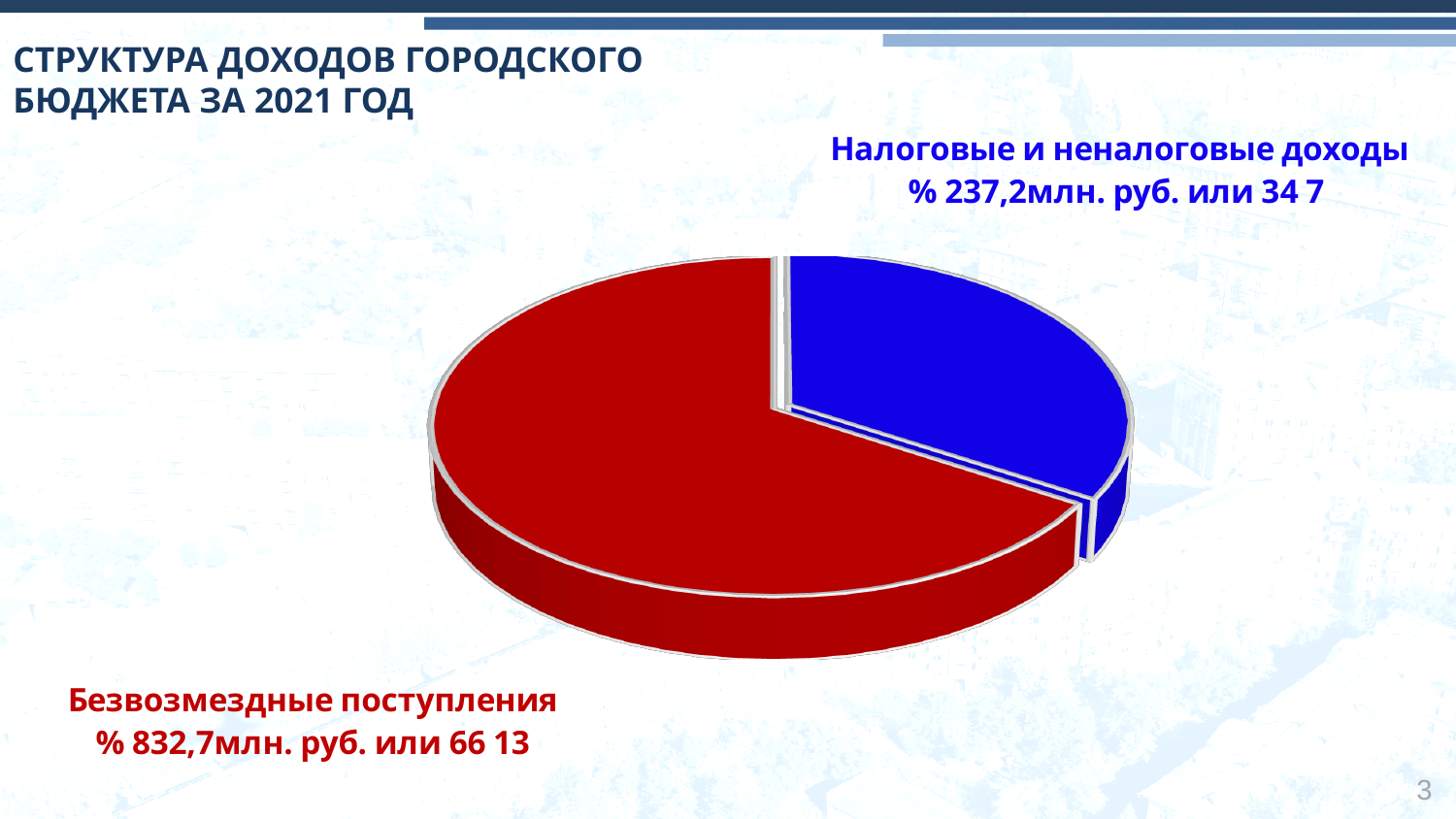
Which is larger: Безвозмездные поступления or Налоговые и неналоговые доходы? Безвозмездные поступления How many slices does the pie chart have? 2 What is the difference in млн. руб. between Безвозмездные поступления and Налоговые и неналоговые доходы? 595,5 млн. руб. What is the value shown for Безвозмездные поступления? 832,7млн. руб. What is the title of the slide containing the pie chart? СТРУКТУРА ДОХОДОВ ГОРОДСКОГО БЮДЖЕТА ЗА 2021 ГОД Which category has the largest share of the pie? Безвозмездные поступления What colour is the slice for Безвозмездные поступления? Red Which category has the smallest share of the pie? Налоговые и неналоговые доходы What is the value shown for Налоговые и неналоговые доходы? 237,2млн. руб. What type of chart is shown on the slide? Pie chart